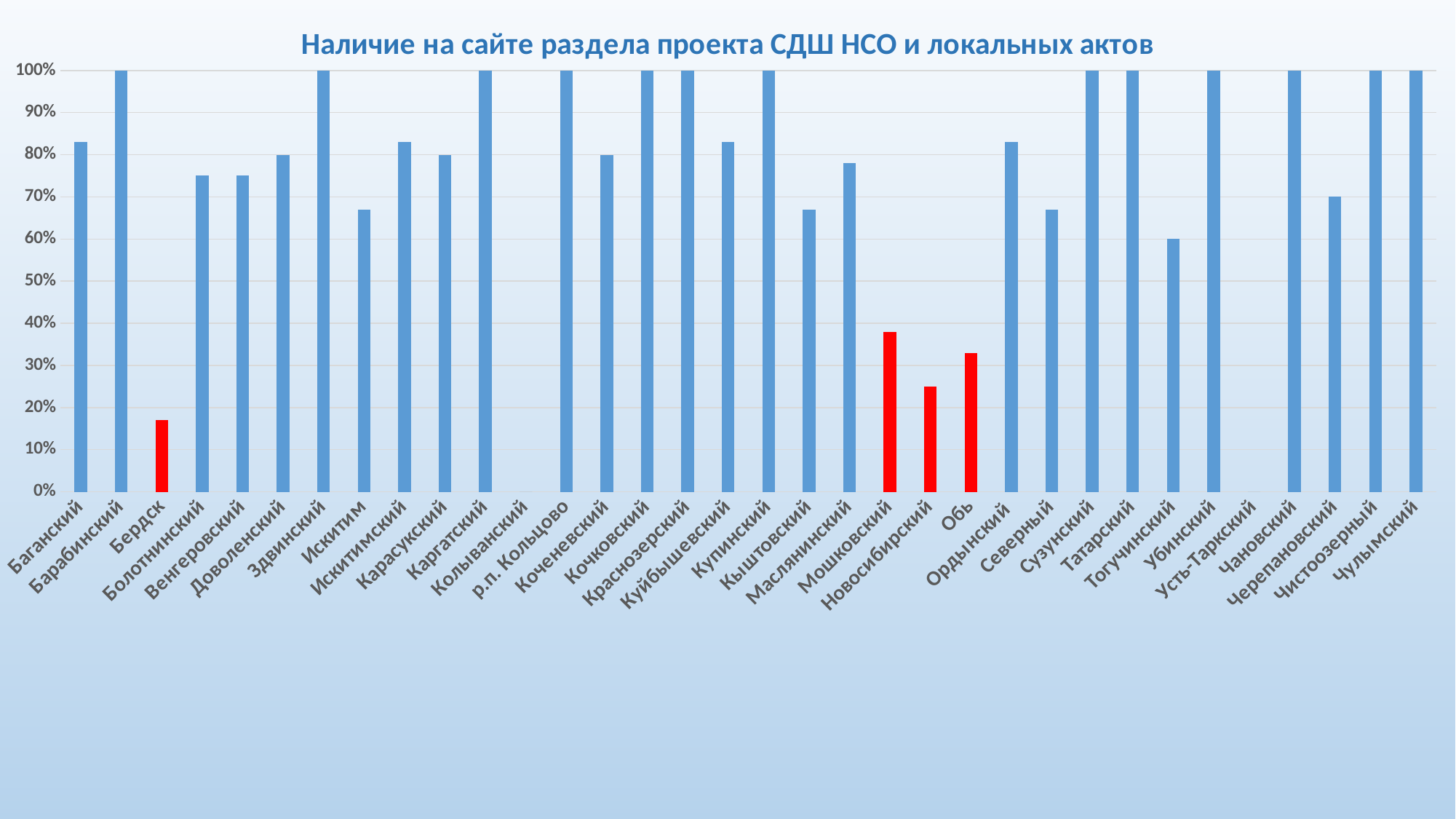
What kind of chart is shown on the slide? bar chart What is the value for Черепановский? 70% Is the value for Бердск greater or less than 20%? less What is the value for Колыванский? 0% What is the value for Барабинский? 100% Which is larger, the value for Мошковский or the value for Новосибирский? Мошковский Is the value for Мошковский greater or less than 40%? less How many bars in the chart are coloured red? 4 Is the value for Баганский greater or less than 80%? greater How many categories are shown on the x axis of the chart? 34 What is the value for Тогучинский? 60% What is the title of the chart? Наличие на сайте раздела проекта СДШ НСО и локальных актов